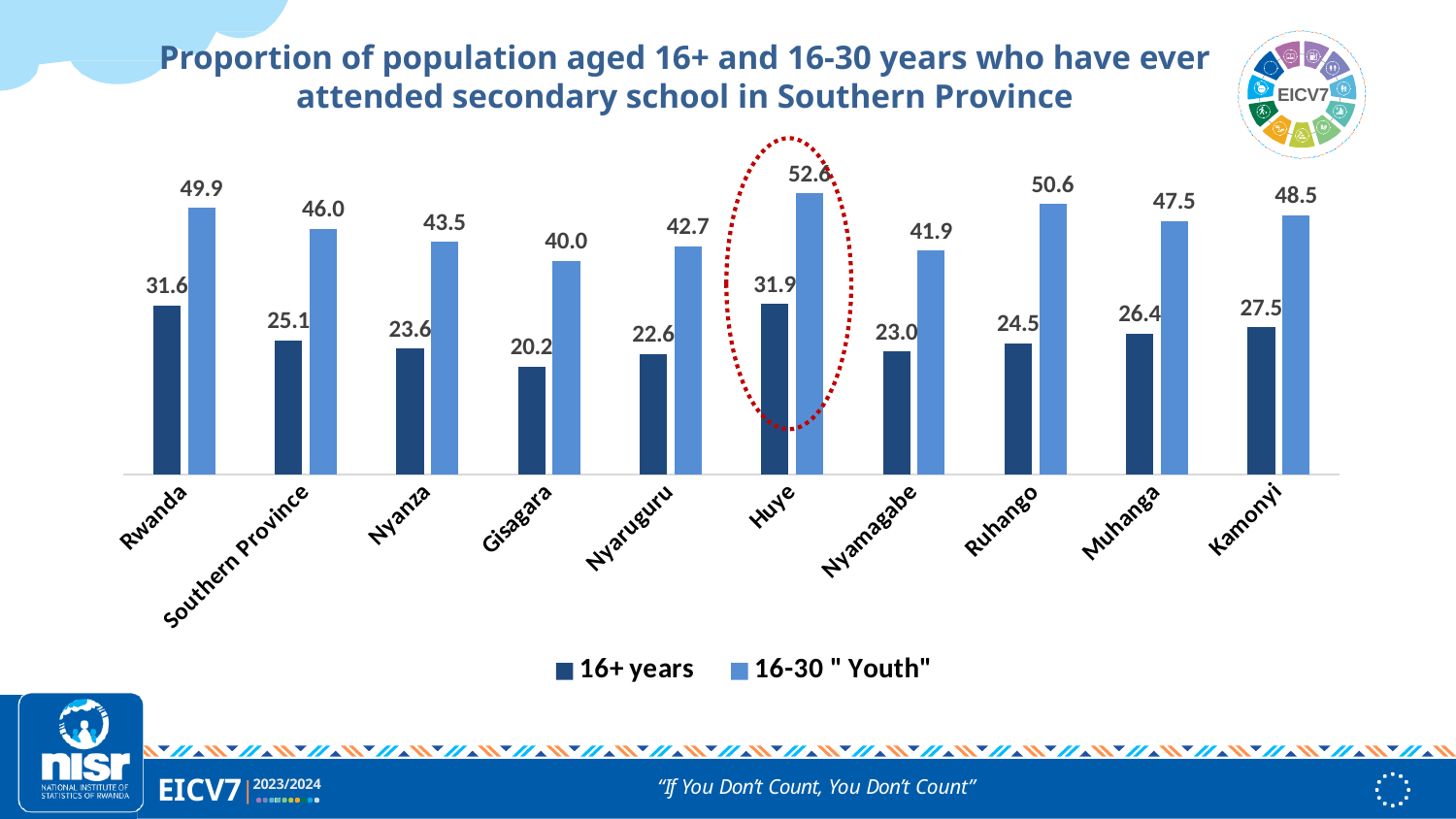
What is the value for Ruhango in the 16-30 "Youth" series? 50.6 What is the value for Southern Province in the 16+ years series? 25.1 How many series does the legend list? 2 How many categories are shown on the x axis? 10 Which category has the highest value in the 16-30 "Youth" series? Huye Which category is highlighted with a red dotted circle? Huye What kind of chart is shown on the slide? Bar chart What is the value for Huye in the 16-30 "Youth" series? 52.6 Which is larger: the 16-30 "Youth" value for Kamonyi or for Muhanga? Kamonyi What is the value for Gisagara in the 16+ years series? 20.2 Which category has the lowest value in the 16+ years series? Gisagara What is the difference between the 16-30 "Youth" value and the 16+ years value for Huye? 20.7